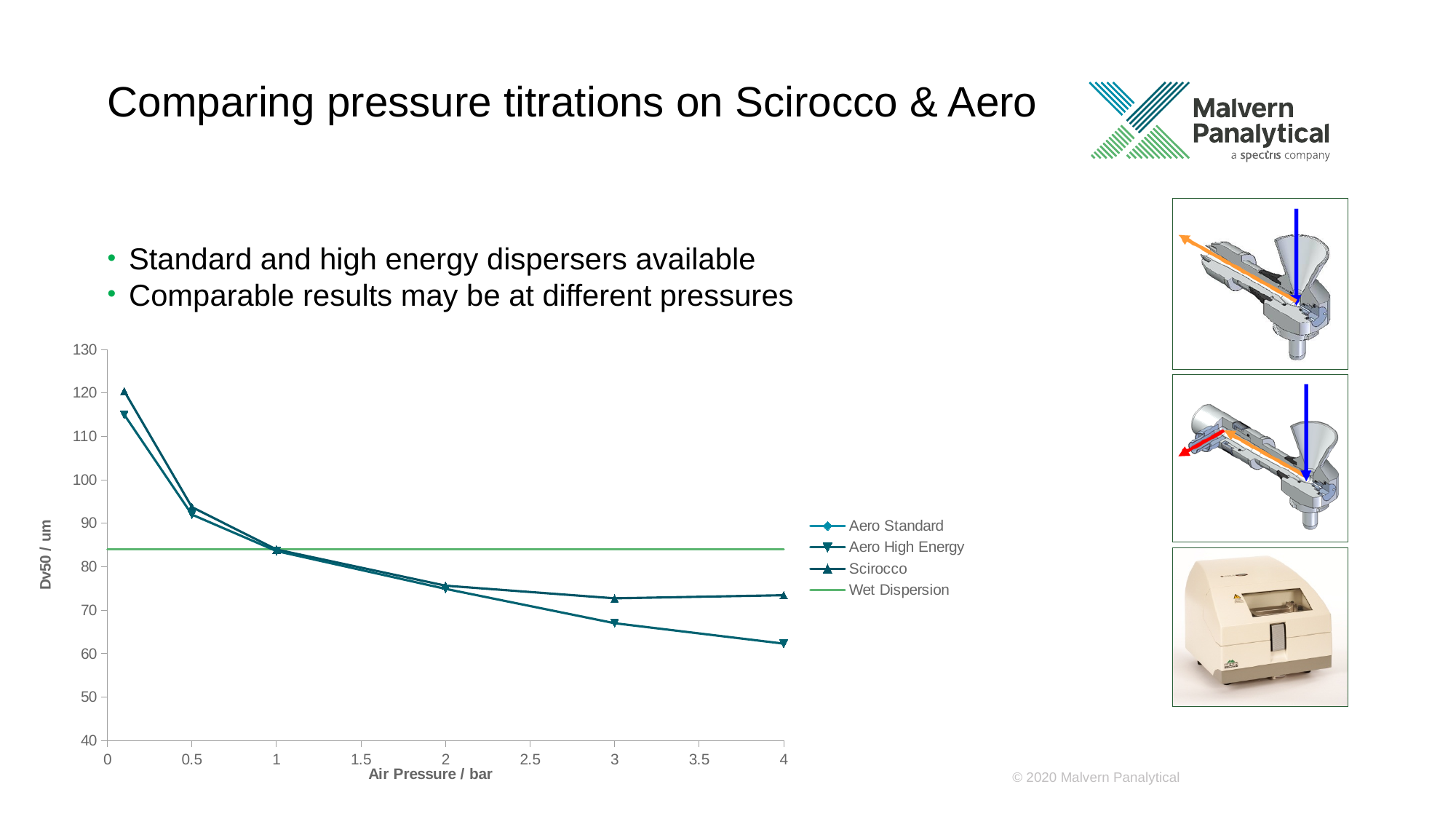
At 0.1 bar, which series has the higher Dv50: Scirocco or Aero High Energy? Scirocco What is the y-axis title of the chart? Dv50 / um What kind of chart is shown on the slide? line chart Is the Scirocco value at 4 bar greater or less than 70? greater How many series does the chart legend list? 4 Is the Aero High Energy value at 4 bar greater or less than 70? less Is the Scirocco value at 0.1 bar greater or less than 110? greater What is the x-axis title of the chart? Air Pressure / bar How many data points are plotted for the Scirocco series? 6 Does the Aero High Energy series rise or fall as air pressure increases from 0.1 to 4 bar? fall At 4 bar, which series has the higher Dv50: Scirocco or Aero High Energy? Scirocco